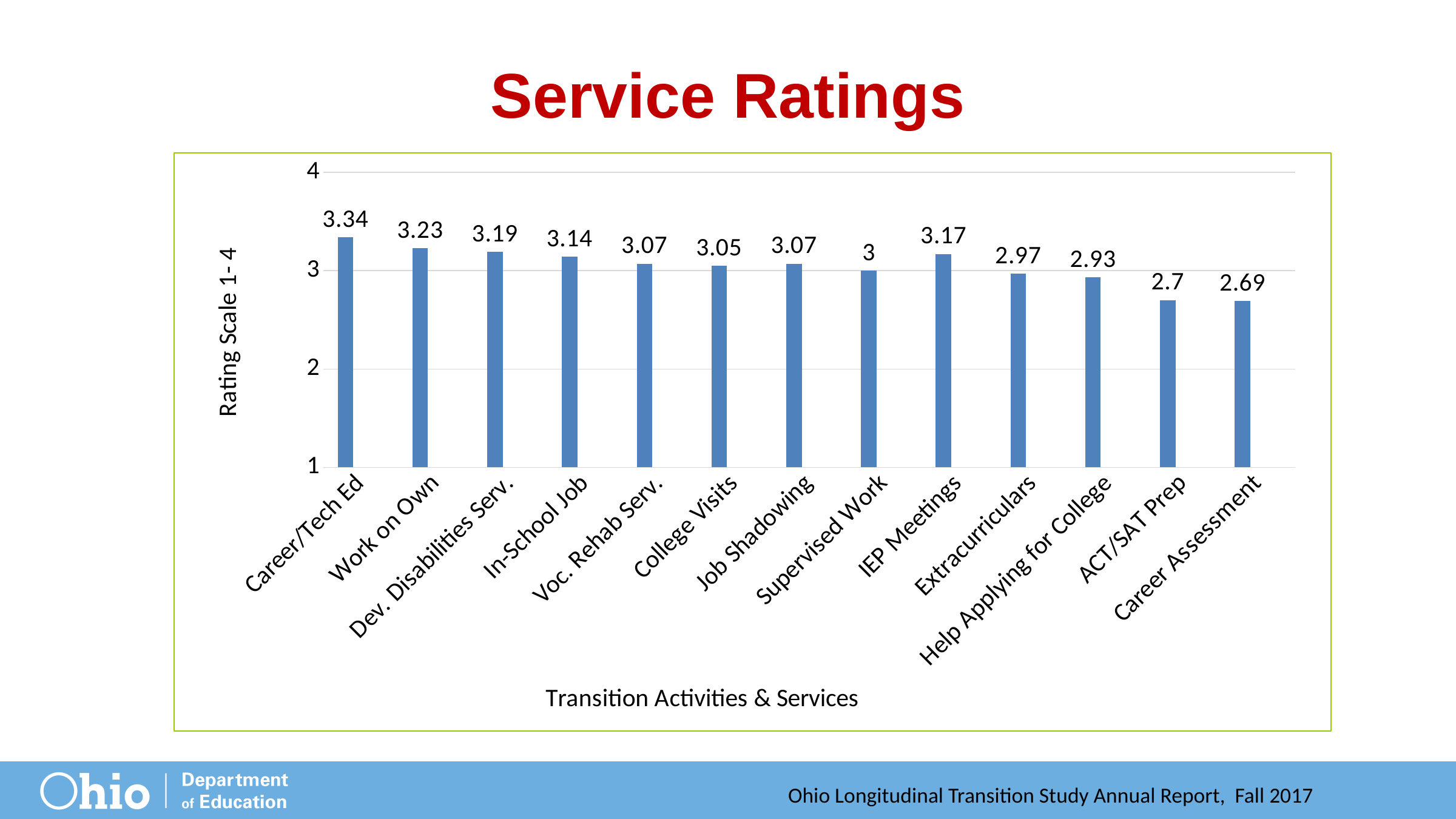
How many transition activities and services are shown in the chart? 13 What is the label of the horizontal axis? Transition Activities & Services Which transition activity or service has the highest rating? Career/Tech Ed What is the rating for Career/Tech Ed? 3.34 What is the label of the vertical axis? Rating Scale 1- 4 Which transition activity or service has the lowest rating? Career Assessment What is the rating for Supervised Work? 3 Which has a higher rating, IEP Meetings or Extracurriculars? IEP Meetings What is the difference between the ratings for Career/Tech Ed and Career Assessment? 0.65 Is the rating for ACT/SAT Prep greater or less than 3? less What is the rating for Help Applying for College? 2.93 What kind of chart is shown on the slide? Bar chart